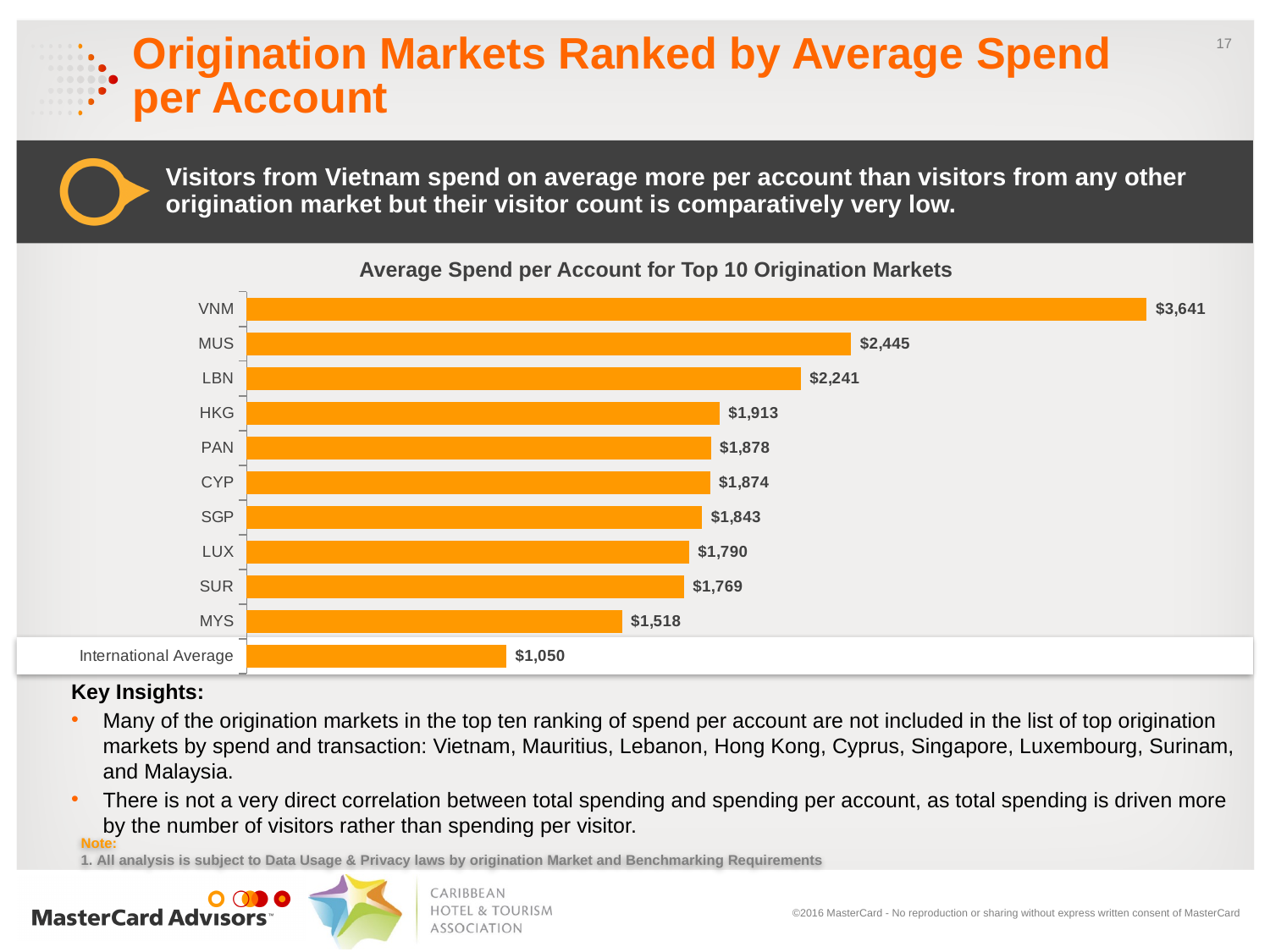
Which has a higher average spend per account, LUX or SUR? LUX What is the average spend per account for HKG? $1,913 Which has a higher average spend per account, LBN or SGP? LBN What is the difference between the average spend per account for VNM and MUS? $1,196 How many bars are shown in the chart, including the International Average? 11 What is the title of the chart? Average Spend per Account for Top 10 Origination Markets What is the value shown for International Average? $1,050 What type of chart is used to show average spend per account? Bar chart Which of the top 10 origination markets has the lowest average spend per account? MYS What is the average spend per account for VNM? $3,641 Which origination market has the highest average spend per account? VNM What is the difference between the average spend per account for MYS and the International Average? $468